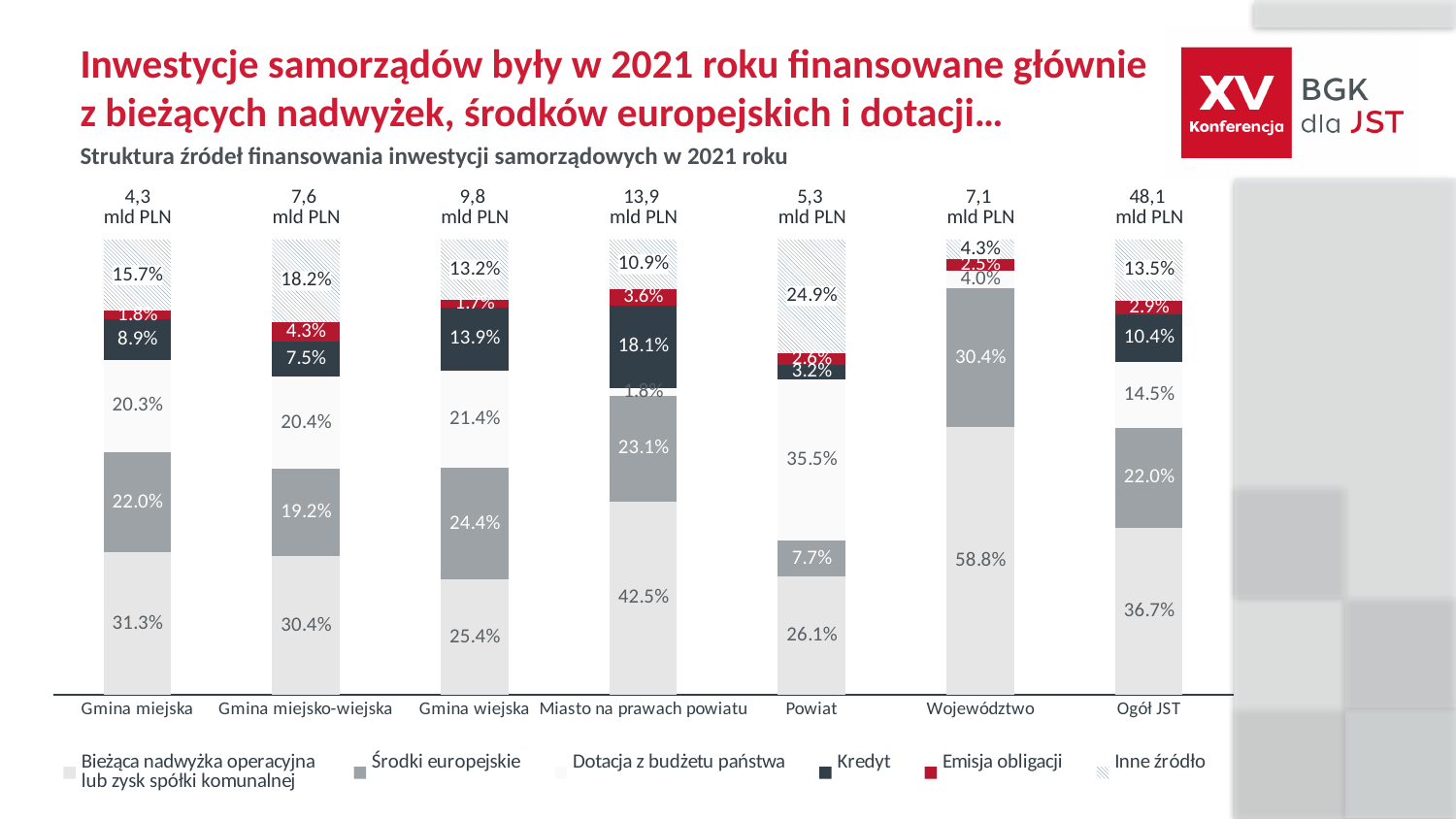
What is the Kredyt share for Miasto na prawach powiatu? 18.1% Which category has the lowest Środki europejskie share? Powiat What is the difference between the Bieżąca nadwyżka operacyjna share for Województwo and for Ogół JST? 22.1 percentage points What share of investment financing for Gmina miejska comes from Bieżąca nadwyżka operacyjna lub zysk spółki komunalnej? 31.3% What kind of chart is shown on the slide? Stacked bar chart What is the Środki europejskie share for Gmina wiejska? 24.4% How many series does the legend list? 6 Which has a larger Inne źródło share: Powiat or Gmina wiejska? Powiat Which category has the highest share of Bieżąca nadwyżka operacyjna lub zysk spółki komunalnej? Województwo What total investment amount (in mld PLN) is shown above the Ogół JST bar? 48,1 mld PLN What is the Dotacja z budżetu państwa share for Powiat? 35.5% How many categories are shown on the x axis? 7